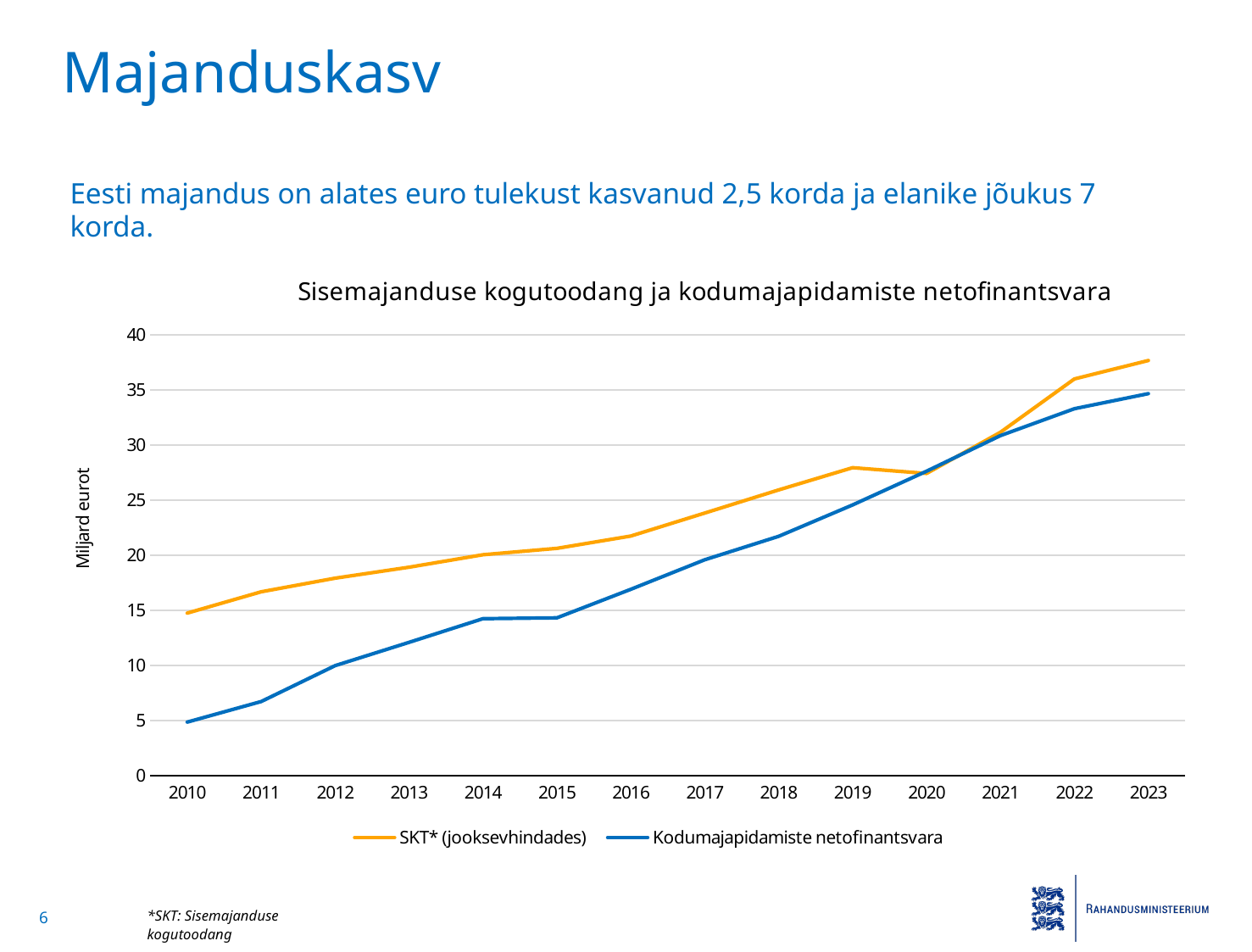
What is the title of the chart? Sisemajanduse kogutoodang ja kodumajapidamiste netofinantsvara In which year is the SKT* (jooksevhindades) series at its highest? 2023 Is the value for SKT* (jooksevhindades) in 2019 greater or less than 25? greater Does the SKT* (jooksevhindades) series generally rise or fall from 2010 to 2023? rise Is the value for Kodumajapidamiste netofinantsvara in 2014 greater or less than 15? less How many series does the legend list? 2 Is the value for SKT* (jooksevhindades) in 2023 greater or less than 35? greater What kind of chart is shown on the slide? line chart How many years are plotted along the x axis? 14 What is the label of the vertical axis? Miljard eurot In which year is the Kodumajapidamiste netofinantsvara series at its lowest? 2010 In 2015, which series has the larger value: SKT* (jooksevhindades) or Kodumajapidamiste netofinantsvara? SKT* (jooksevhindades)